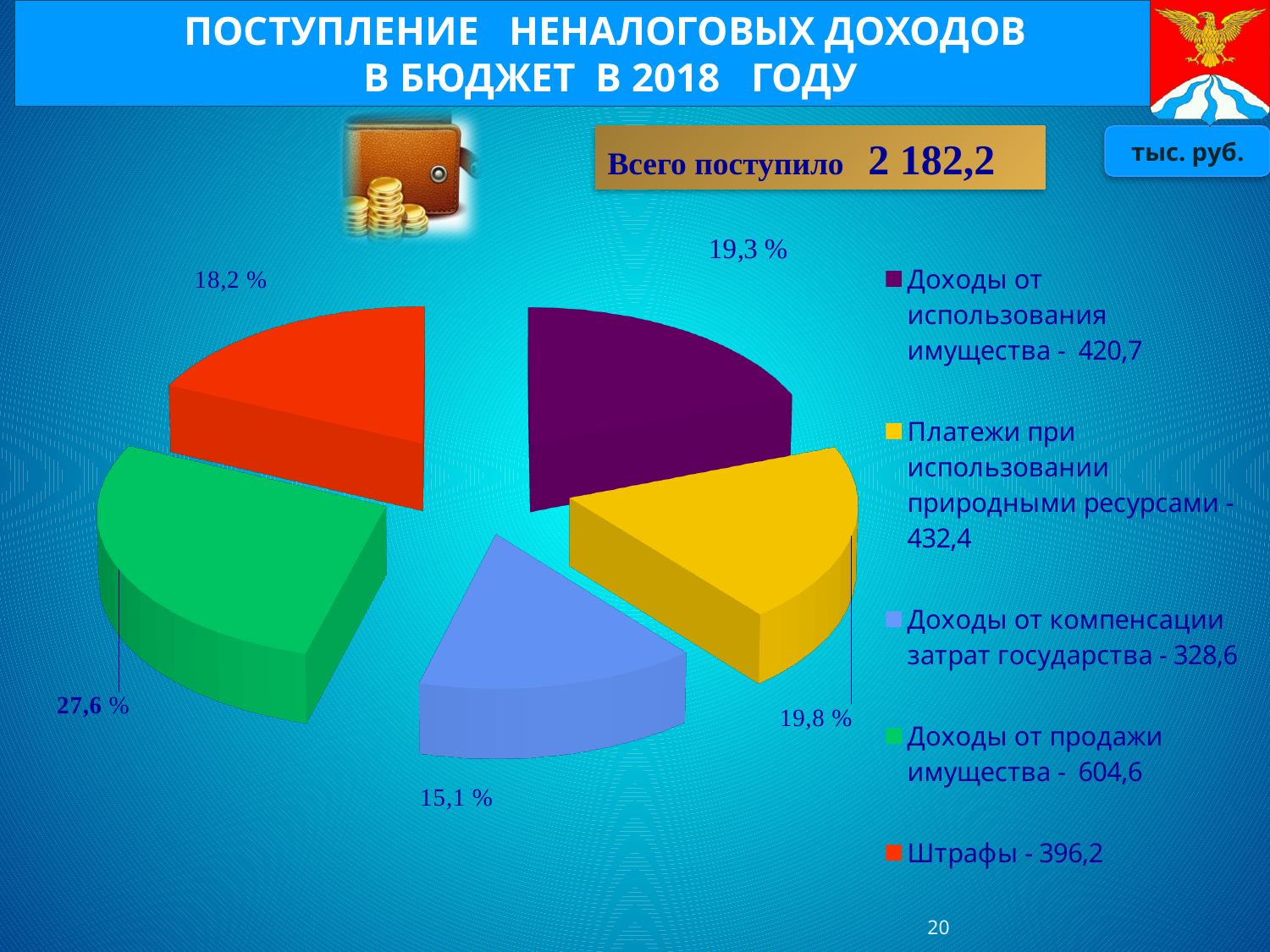
How many entries does the legend list? 5 What kind of chart is shown on the slide? pie chart What value is given in the legend for Доходы от продажи имущества? 604,6 What value is given in the legend for Доходы от компенсации затрат государства? 328,6 Which category has the smallest value? Доходы от компенсации затрат государства What percentage share is labelled for the light blue slice (Доходы от компенсации затрат государства)? 15,1 % How many slices does the pie chart have? 5 Which category has the largest value? Доходы от продажи имущества What percentage share is labelled for the green slice (Доходы от продажи имущества)? 27,6 % What value is given in the legend for Штрафы? 396,2 What total amount (Всего поступило) is shown on the slide? 2 182,2 What is the difference between Доходы от продажи имущества (604,6) and Штрафы (396,2)? 208,4